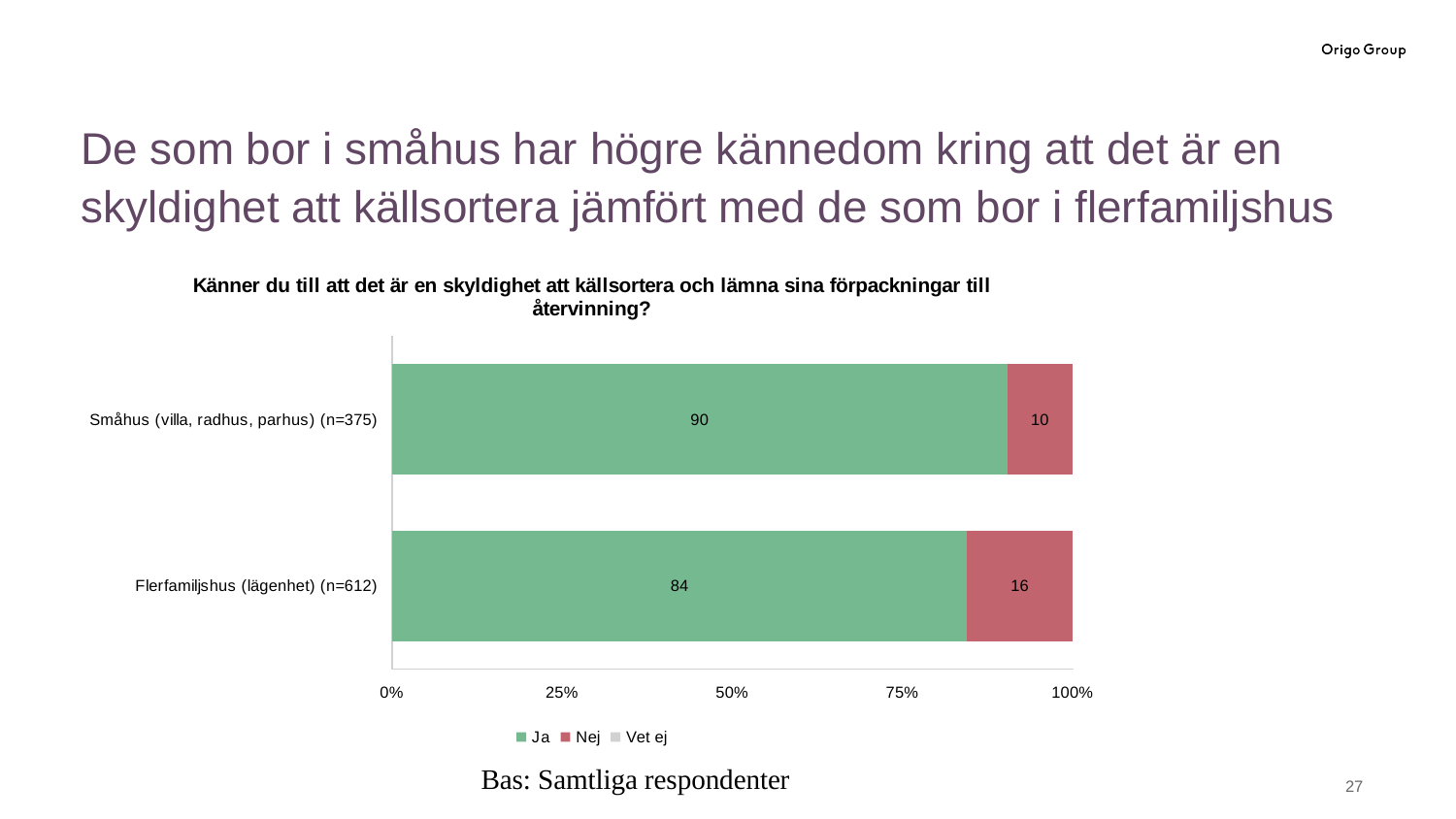
What is the "Ja" value for Småhus (villa, radhus, parhus) (n=375)? 90 What is the difference between the "Ja" values for Småhus and Flerfamiljshus? 6 What is the total of the stacked bar for Flerfamiljshus (lägenhet) (n=612)? 100 Which is larger: the "Nej" value for Flerfamiljshus or the "Nej" value for Småhus? Flerfamiljshus Which category has the highest "Ja" value? Småhus (villa, radhus, parhus) (n=375) How many series does the legend list? 3 What kind of chart is shown on the slide? Stacked bar chart What is the "Nej" value for Småhus (villa, radhus, parhus) (n=375)? 10 Which category has the lowest "Nej" value? Småhus (villa, radhus, parhus) (n=375) What is the "Nej" value for Flerfamiljshus (lägenhet) (n=612)? 16 How many categories are shown on the chart? 2 What is the "Ja" value for Flerfamiljshus (lägenhet) (n=612)? 84